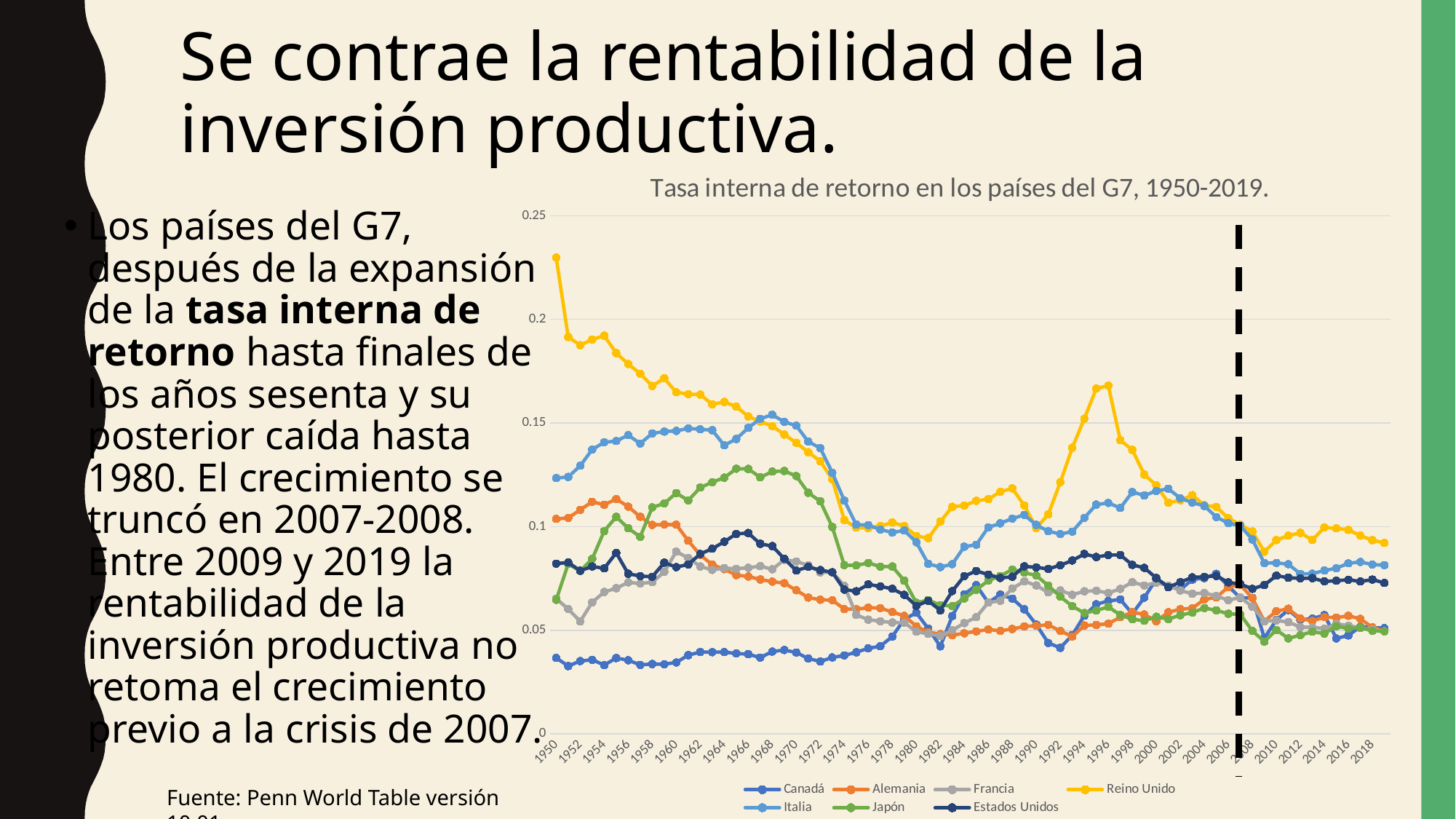
Which country has the highest internal rate of return in 1950? Reino Unido Which colour is used for the Reino Unido series in the chart? yellow How many series does the chart legend list? 7 What kind of chart is shown on the slide? line chart In 1950, which is larger: the value for Reino Unido or the value for Canadá? Reino Unido Is the value for Reino Unido in 1996 greater or less than 0.15? greater Does the value for Reino Unido rise or fall between 1950 and 1980? fall Is the value for Japón in 1966 greater or less than 0.1? greater Is the value for Reino Unido in 1950 greater or less than 0.2? greater What is the title of the chart? Tasa interna de retorno en los países del G7, 1950-2019. Which country has the lowest internal rate of return in 1950? Canadá